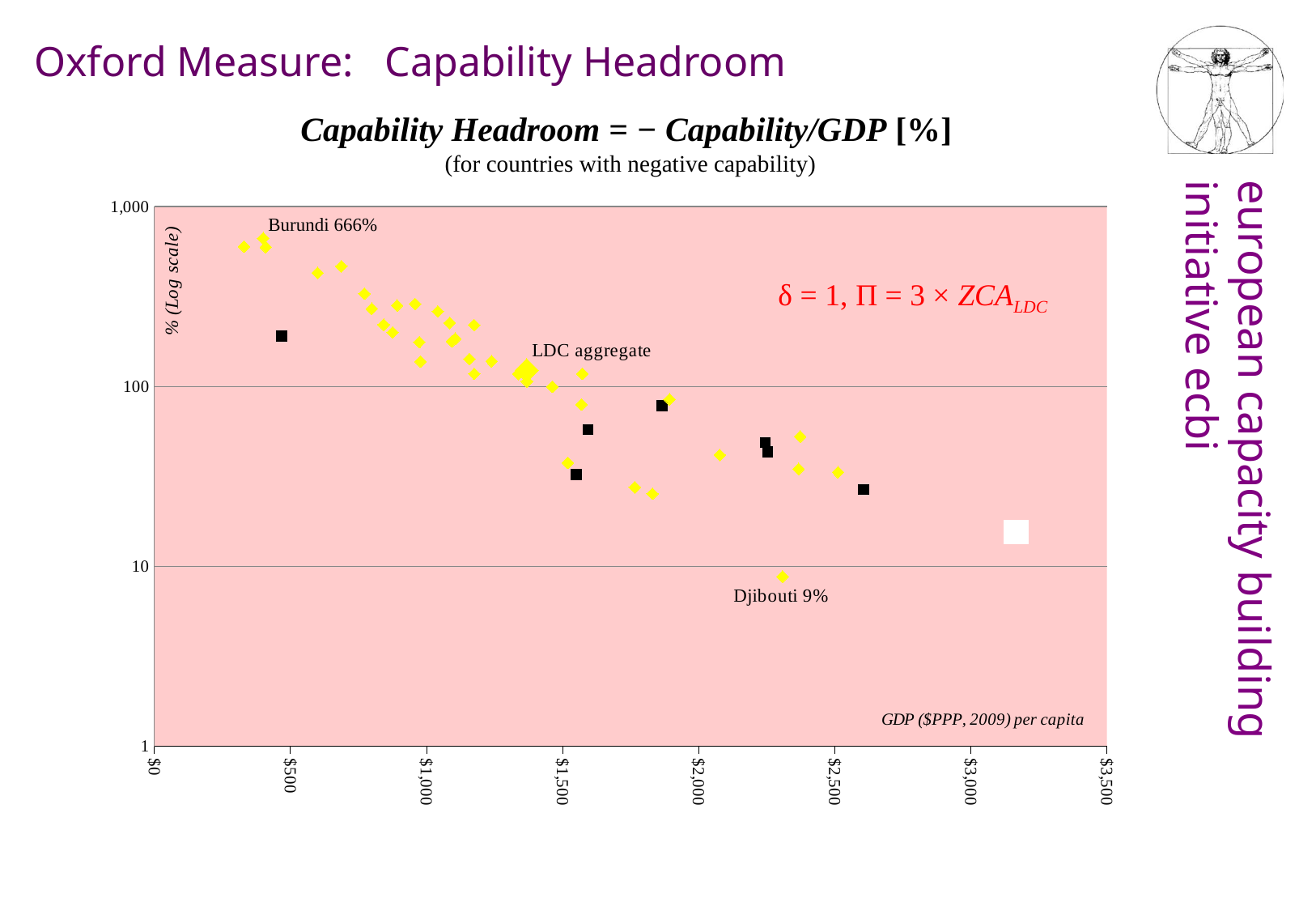
What is the Capability Headroom value labelled for Djibouti? 9% What is the difference between the labelled values for Burundi and Djibouti? 657% What kind of chart is shown on the slide? Scatter chart What kind of scale does the y axis of the chart use? Log scale Which labelled country has the highest Capability Headroom on the chart? Burundi Is the value for Burundi greater or less than 100? greater Is the value for the LDC aggregate point greater or less than 10? greater What is the Capability Headroom value labelled for Burundi? 666% Which has the larger Capability Headroom, Burundi or Djibouti? Burundi What is the label on the x axis of the chart? GDP ($PPP, 2009) per capita Which labelled country has the lowest Capability Headroom on the chart? Djibouti